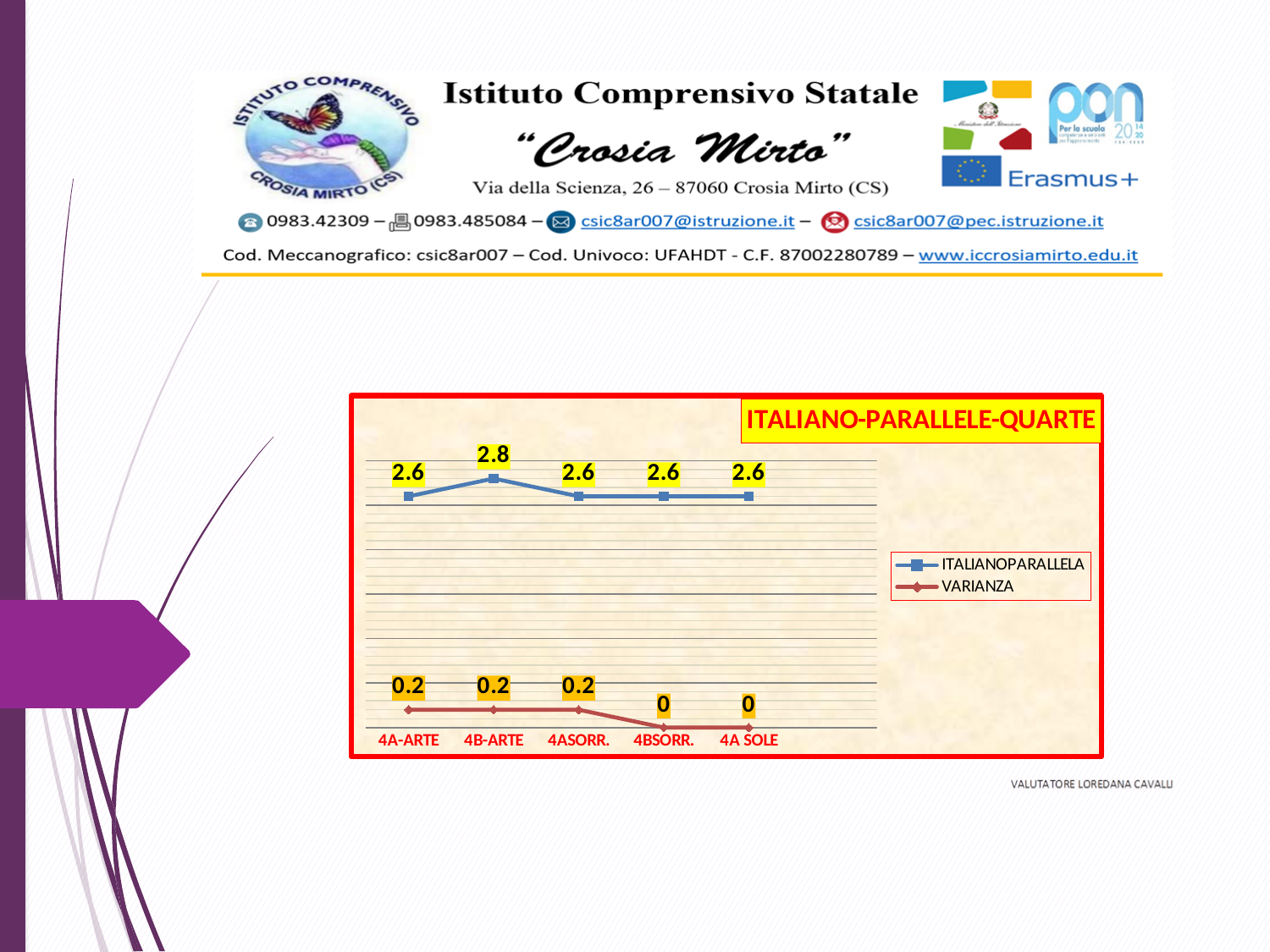
What is the ITALIANOPARALLELA value for 4A SOLE? 2.6 What colour is the VARIANZA line? Red Which category has the highest ITALIANOPARALLELA value? 4B-ARTE What is the difference between the ITALIANOPARALLELA values for 4B-ARTE and 4A-ARTE? 0.2 What is the ITALIANOPARALLELA value for 4B-ARTE? 2.8 How many series does the legend list? 2 How many categories are shown on the x axis? 5 What kind of chart is shown? Line chart What is the title of the chart? ITALIANO-PARALLELE-QUARTE Does the VARIANZA series rise or fall from 4ASORR. to 4BSORR.? Fall What is the VARIANZA value for 4BSORR.? 0 Which is larger, the VARIANZA value for 4ASORR. or for 4BSORR.? 4ASORR.